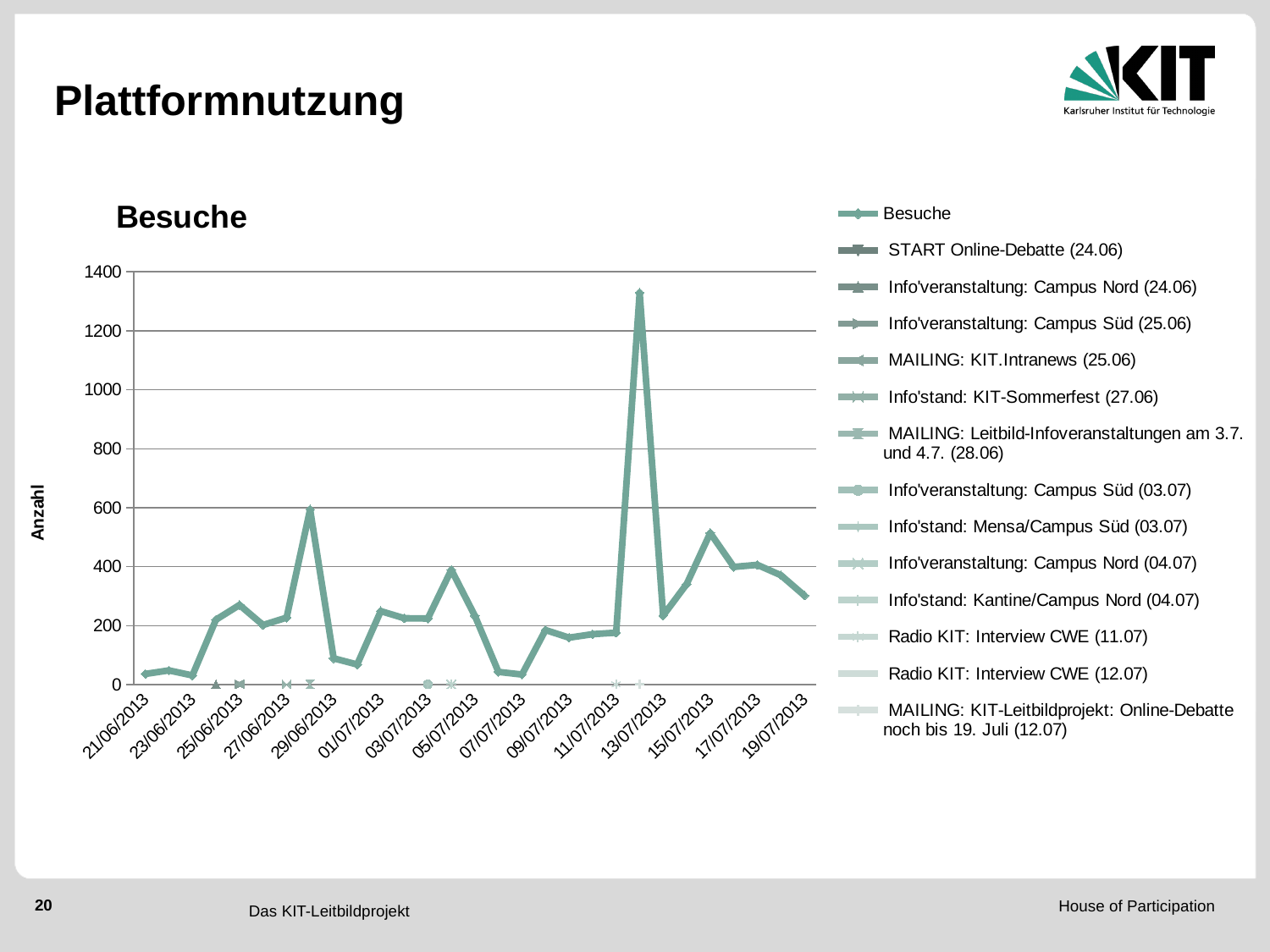
How many entries does the legend list? 14 What is the label of the y axis? Anzahl What kind of chart is shown on the slide? line chart Is the value for Besuche on 15/07/2013 greater or less than 400? greater What is the title of the chart? Besuche How many date labels are shown on the x axis? 15 Does the Besuche line rise or fall from 15/07/2013 to 19/07/2013? fall Is the highest value of the Besuche line greater or less than 1200? greater Is the value for Besuche on 19/07/2013 greater or less than 400? less Which has the larger Besuche value, 29/06/2013 or 05/07/2013? 05/07/2013